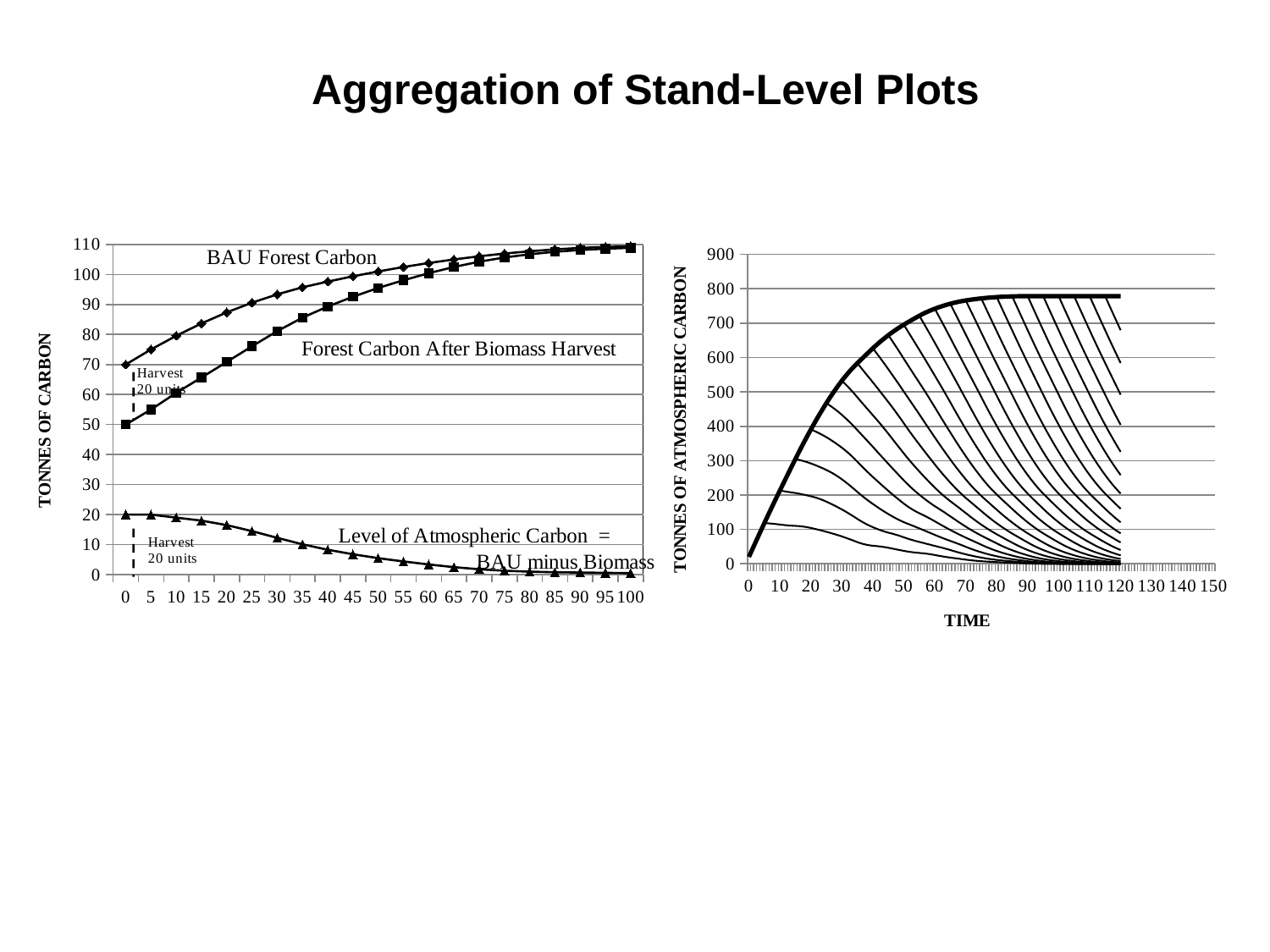
On the left chart, which is larger at time 0: BAU Forest Carbon or Forest Carbon After Biomass Harvest? BAU Forest Carbon On the left chart, does the Level of Atmospheric Carbon rise or fall as time increases? fall On the left chart, what is the Level of Atmospheric Carbon at time 0? 20 On the left chart, what is the value of BAU Forest Carbon at time 0? 70 On the left chart, is Forest Carbon After Biomass Harvest at time 20 greater or less than 60? greater What kind of chart is the left chart? line chart On the left chart, what is the value of Forest Carbon After Biomass Harvest at time 0? 50 What is the x-axis title of the right chart? TIME On the left chart, is the Level of Atmospheric Carbon at time 50 greater or less than 10? less On the right chart, is the thick aggregate line at time 40 greater or less than 500? greater On the left chart, what is the difference between BAU Forest Carbon and Forest Carbon After Biomass Harvest at time 0? 20